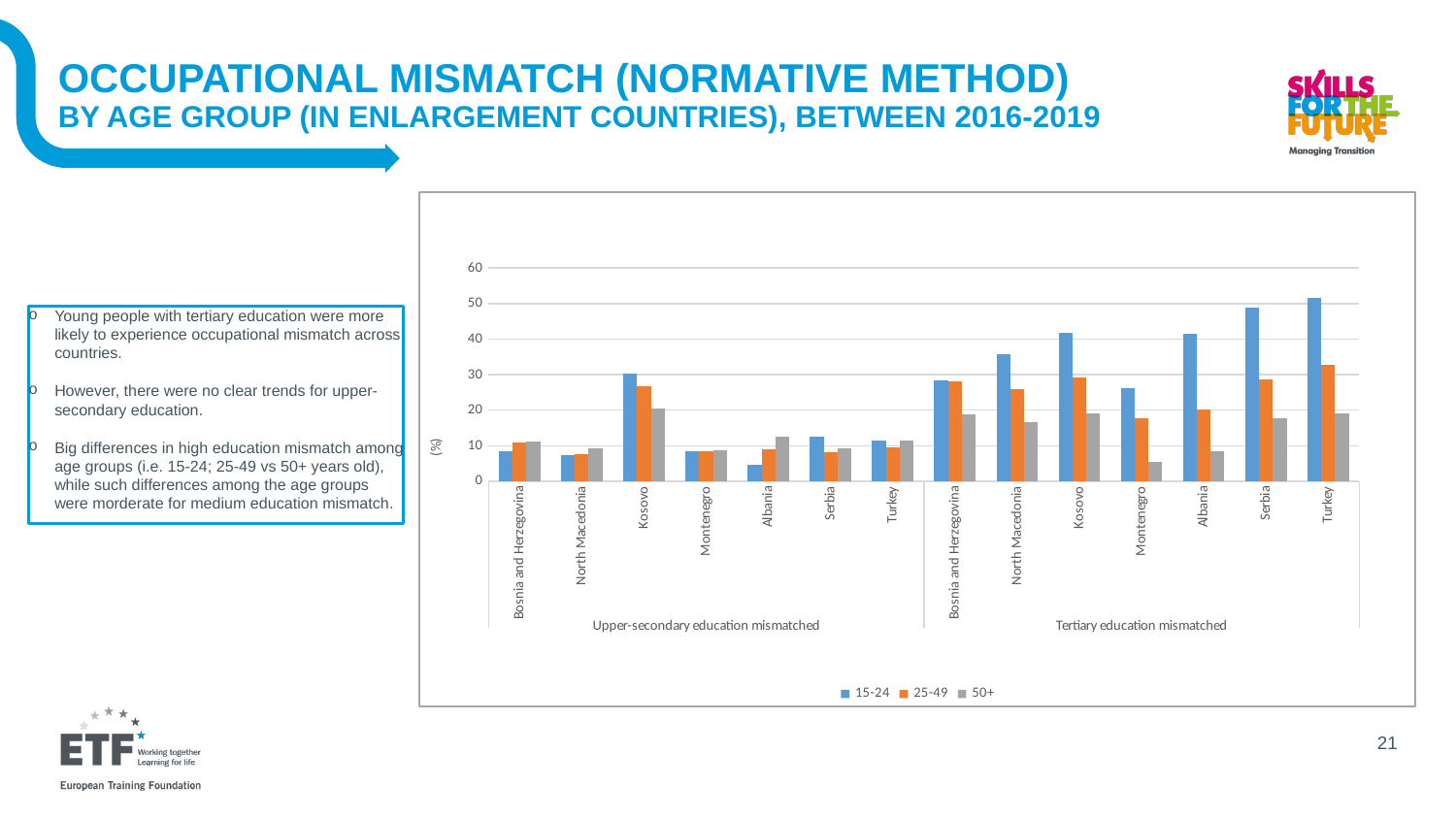
Which country has the lowest 50+ value in the 'Tertiary education mismatched' group? Montenegro What kind of chart is shown on the slide? bar chart How many series does the legend list? 3 Is the 15-24 value for Kosovo in the 'Upper-secondary education mismatched' group greater or less than 20? greater Which country has the highest 15-24 value in the 'Tertiary education mismatched' group? Turkey What is the label on the vertical axis of the chart? (%) Which country has the highest 15-24 value in the 'Upper-secondary education mismatched' group? Kosovo For Albania in the 'Upper-secondary education mismatched' group, which is larger: the 15-24 value or the 50+ value? 50+ How many countries are shown in the 'Tertiary education mismatched' group? 7 Is the 50+ value for Montenegro in the 'Tertiary education mismatched' group greater or less than 10? less What are the three series listed in the legend? 15-24, 25-49, 50+ Is the 15-24 value for Turkey in the 'Tertiary education mismatched' group greater or less than 40? greater